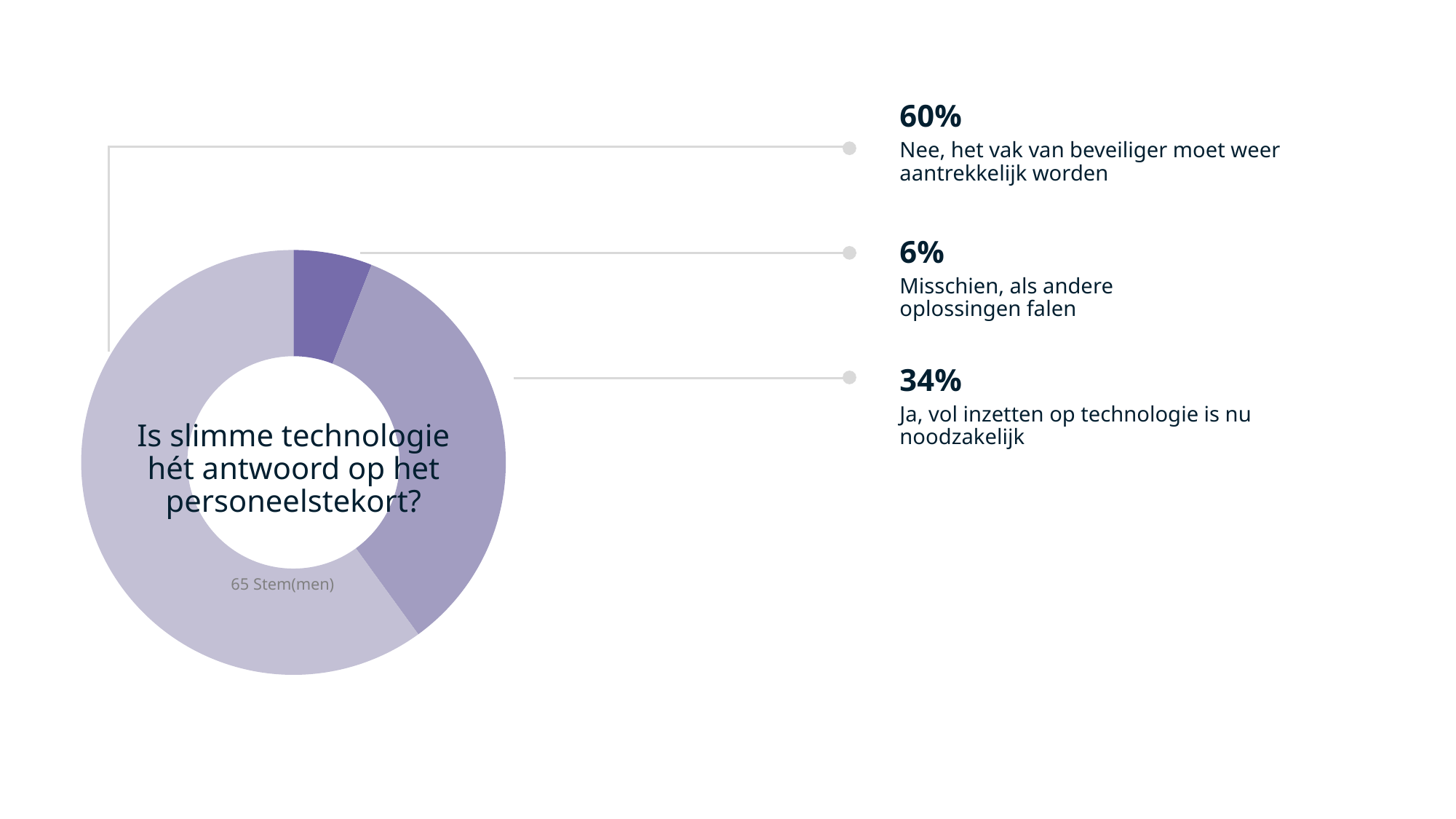
What question is written in the centre of the chart? Is slimme technologie hét antwoord op het personeelstekort? What share of votes answered "Ja, vol inzetten op technologie is nu noodzakelijk"? 34% What share of votes answered "Misschien, als andere oplossingen falen"? 6% What is the difference in percentage points between the "Ja" answer and the "Misschien" answer? 28 Which answer option received the largest share of votes? Nee, het vak van beveiliger moet weer aantrekkelijk worden What kind of chart is shown on the slide? Pie chart (donut) What share of votes answered "Nee, het vak van beveiliger moet weer aantrekkelijk worden"? 60% What is the difference in percentage points between the "Nee" answer and the "Ja" answer? 26 Which received a larger share: the "Ja" answer or the "Misschien" answer? Ja, vol inzetten op technologie is nu noodzakelijk How many answer options are shown in the chart? 3 Which answer option received the smallest share of votes? Misschien, als andere oplossingen falen How many votes does the chart say were cast? 65 Stem(men)